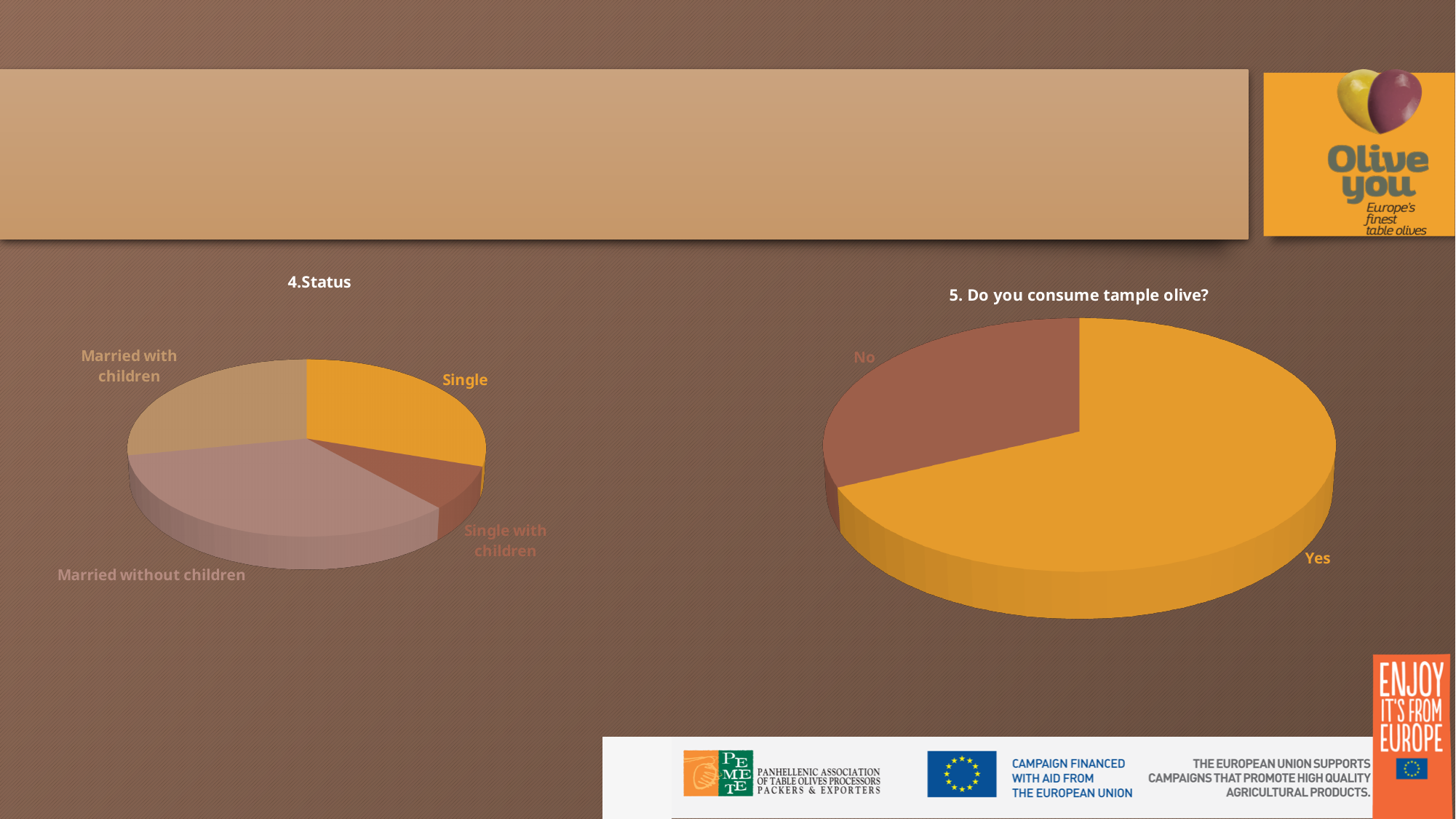
In the "4.Status" chart, which category has the largest slice? Married without children What kind of chart is the "5. Do you consume tample olive?" chart? pie chart In the "4.Status" chart, which category has the smallest slice? Single with children What kind of chart is the "4.Status" chart? pie chart In the "4.Status" chart, which slice is larger: Married without children or Married with children? Married without children How many slices does the "5. Do you consume tample olive?" pie chart have? 2 What is the title of the pie chart on the right side of the slide? 5. Do you consume tample olive? In the "5. Do you consume tample olive?" chart, which answer has the larger slice? Yes In the "4.Status" chart, which slice is larger: Single or Single with children? Single What is the title of the pie chart on the left side of the slide? 4.Status How many slices does the "4.Status" pie chart have? 4 In the "5. Do you consume tample olive?" chart, which answer has the smaller slice? No